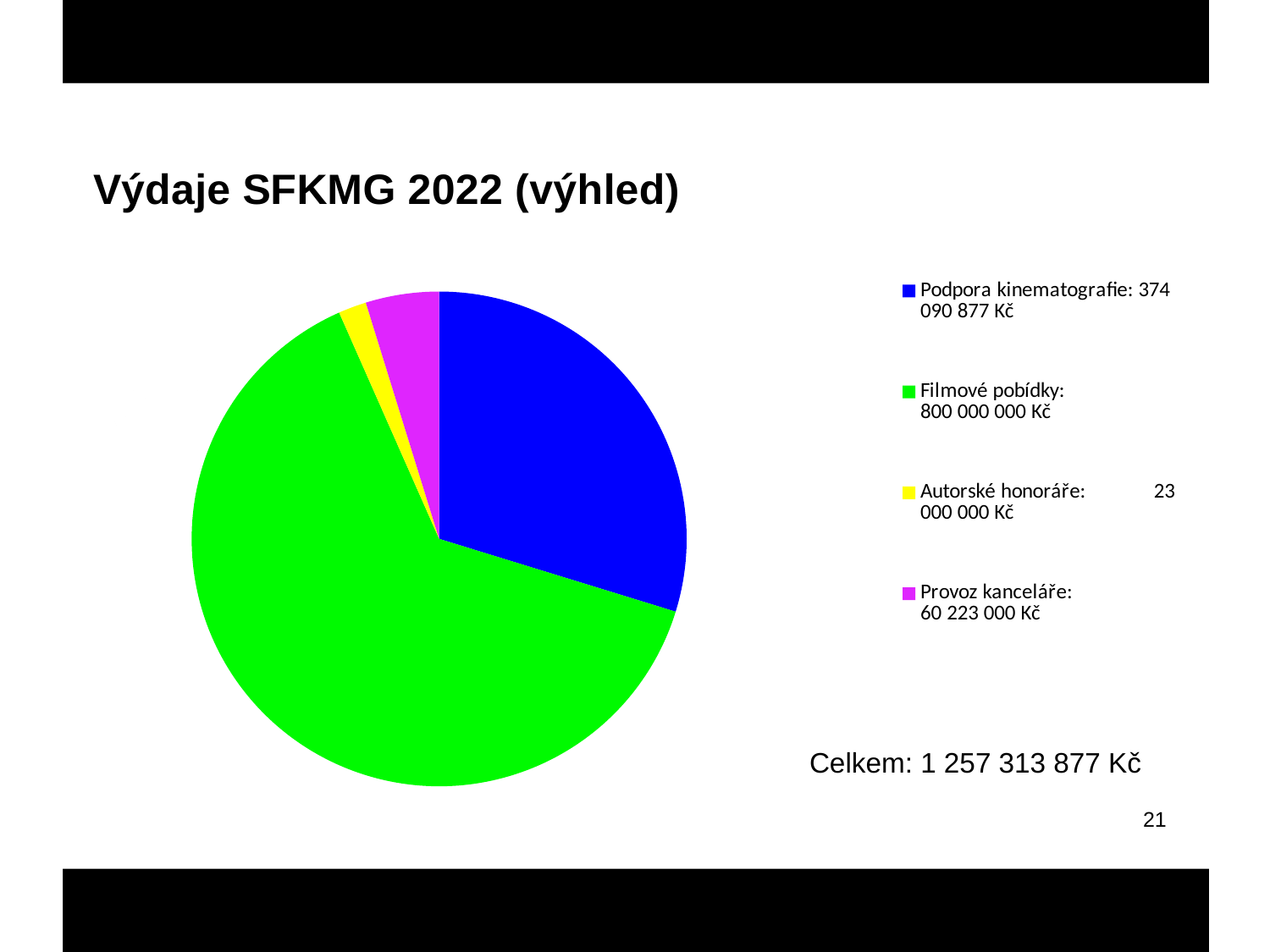
Which category has the largest share of the pie? Filmové pobídky How many categories does the pie chart show? 4 What is the value for Filmové pobídky? 800 000 000 Kč What is the value for Podpora kinematografie? 374 090 877 Kč What kind of chart is shown on the slide? pie chart What is the value for Autorské honoráře? 23 000 000 Kč What is the total of all categories shown (Celkem)? 1 257 313 877 Kč Which is larger, Podpora kinematografie or Provoz kanceláře? Podpora kinematografie What is the difference between Filmové pobídky and Podpora kinematografie? 425 909 123 Kč Which category has the smallest share of the pie? Autorské honoráře What is the value for Provoz kanceláře? 60 223 000 Kč What is the title of the slide? Výdaje SFKMG 2022 (výhled)